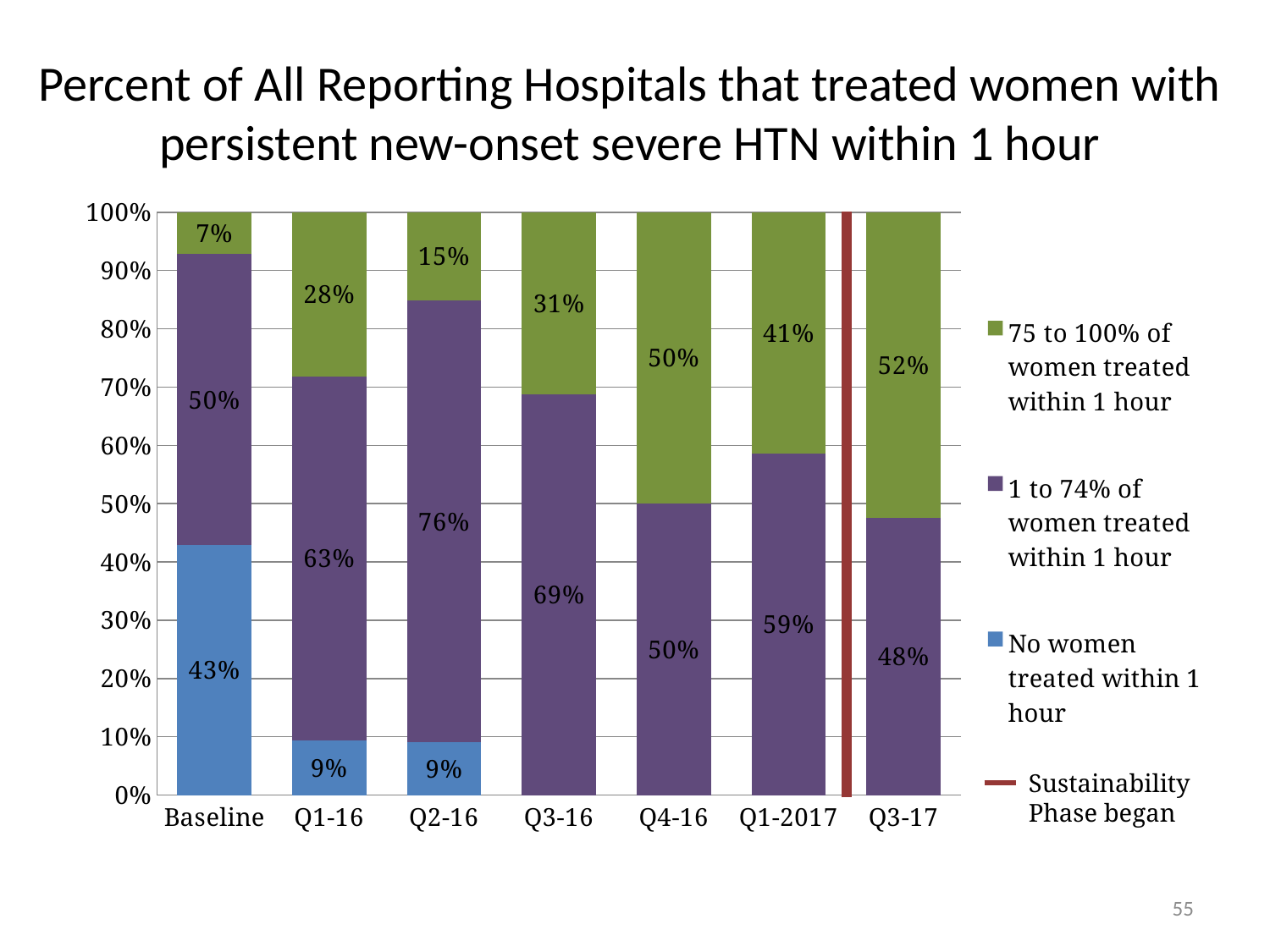
Does the '75 to 100% of women treated within 1 hour' value generally rise or fall from Baseline to Q3-17? Rise What does the red vertical line between Q1-2017 and Q3-17 indicate, according to the legend? Sustainability Phase began What is the value for '75 to 100% of women treated within 1 hour' in Q3-17? 52% In which period is the '1 to 74% of women treated within 1 hour' segment the largest? Q2-16 How many time-period categories are shown on the x axis? 7 What kind of chart is shown on the slide? Stacked bar chart What is the difference between the '75 to 100% of women treated within 1 hour' values for Q3-17 and Baseline? 45% In which period is the '75 to 100% of women treated within 1 hour' segment the smallest? Baseline How many entries does the legend list? 4 What is the value for '1 to 74% of women treated within 1 hour' in Q2-16? 76% What percent of hospitals had no women treated within 1 hour at Baseline? 43% Which is larger: the '75 to 100% of women treated within 1 hour' value in Q1-16 or in Q3-16? Q3-16